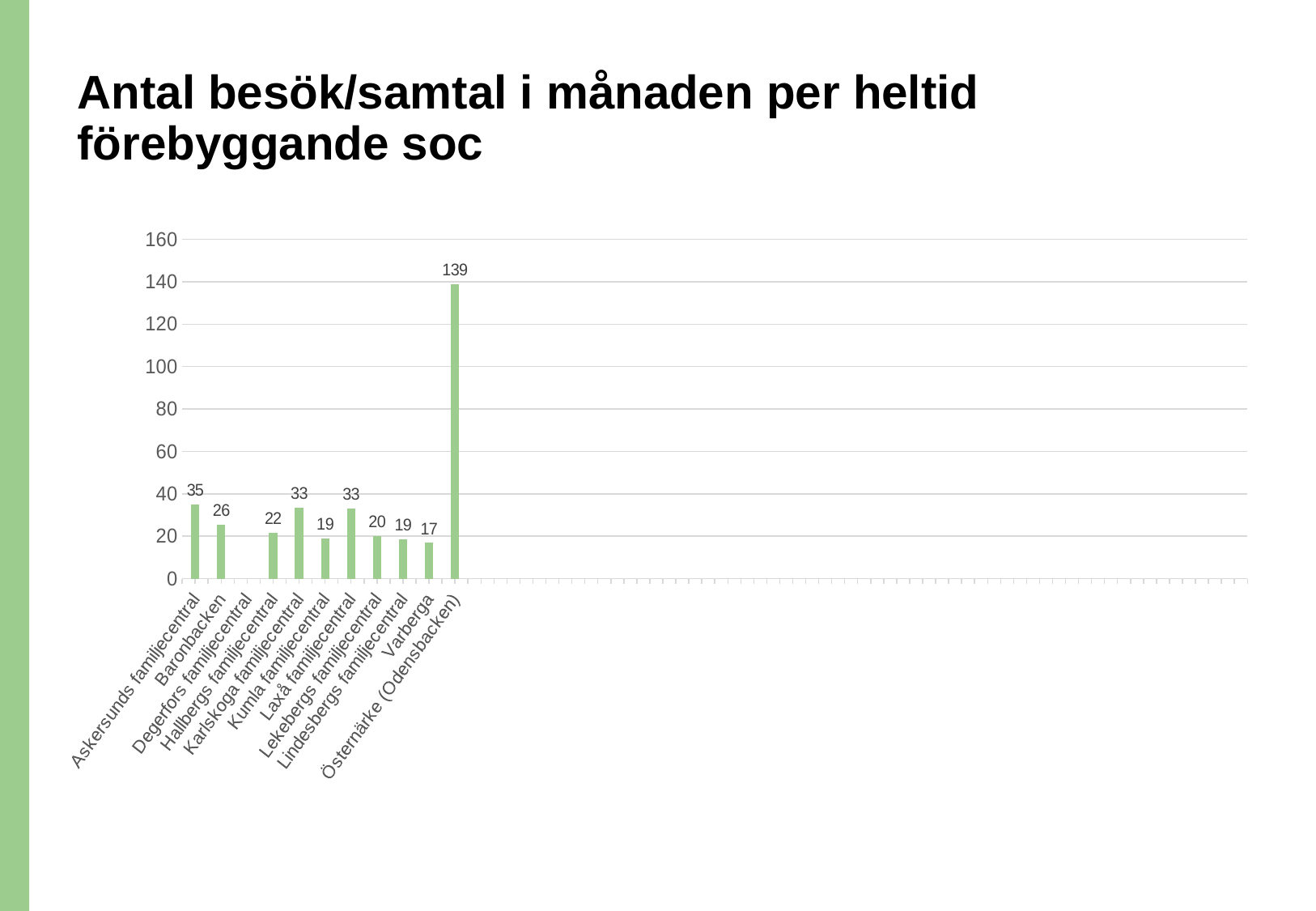
Which category has the highest value? Östernärke (Odensbacken) Among the bars shown, which category has the lowest value? Varberga What is the value for Askersunds familjecentral? 35 How many categories are labelled on the x axis? 11 What kind of chart is shown on the slide? bar chart Which is larger, the value for Baronbacken or the value for Hallbergs familjecentral? Baronbacken What is the difference between the values for Östernärke (Odensbacken) and Askersunds familjecentral? 104 What is the difference between the values for Askersunds familjecentral and Baronbacken? 9 What is the value for Östernärke (Odensbacken)? 139 What is the value for Karlskoga familjecentral? 33 What is the value for Varberga? 17 Is the value for Östernärke (Odensbacken) greater or less than 100? greater